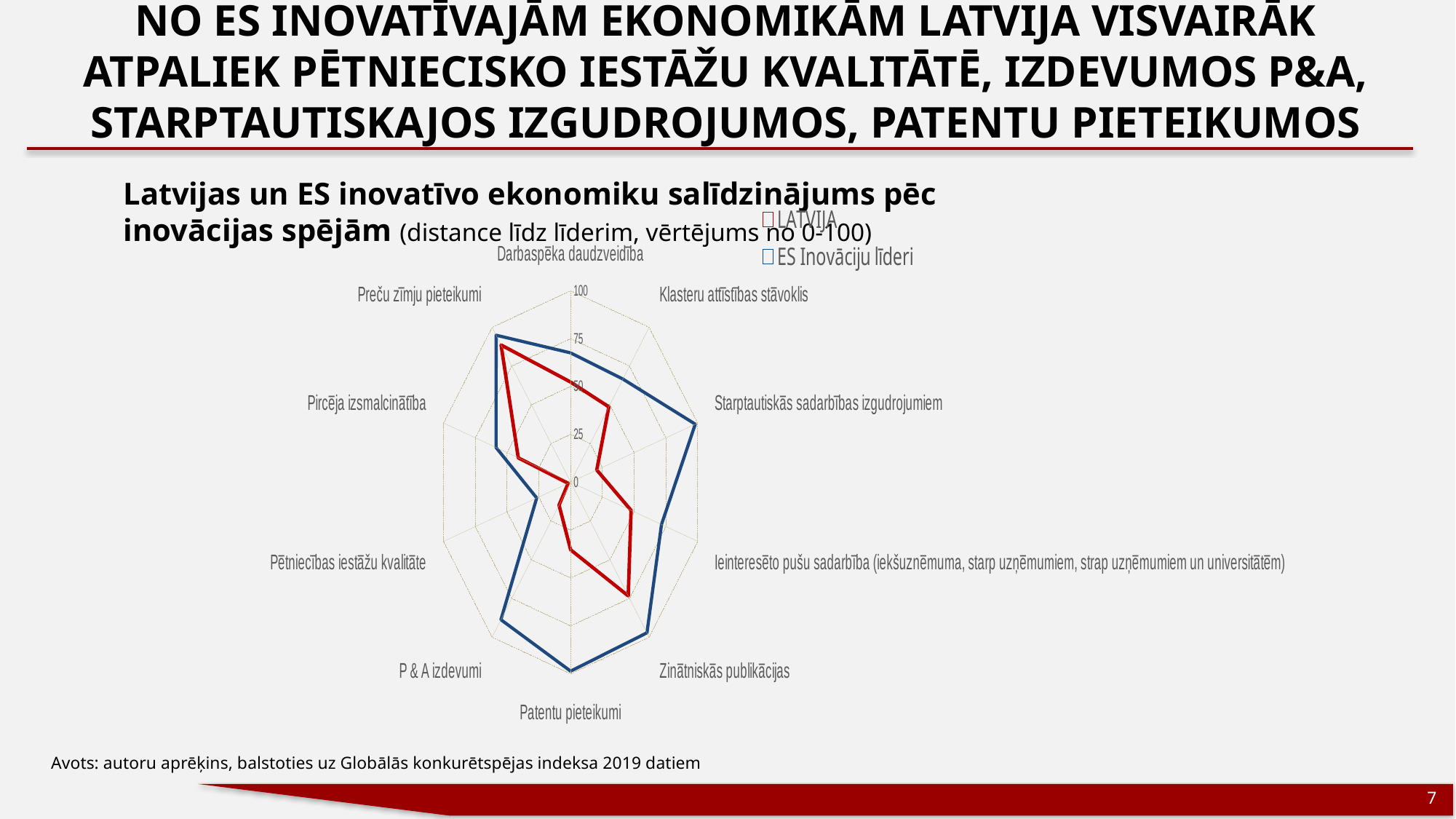
How many categories (axes) does the radar chart have? 10 What are the two series named in the legend? LATVIJA and ES Inovāciju līderi Which series is drawn in red on the chart? LATVIJA Is the value for LATVIJA on Pētniecības iestāžu kvalitāte greater or less than 25? less Is the value for LATVIJA on Patentu pieteikumi greater or less than 50? less Which series has the larger value on Patentu pieteikumi, LATVIJA or ES Inovāciju līderi? ES Inovāciju līderi How many series does the chart legend list? 2 What kind of chart is shown on the slide? Radar chart On which category does the LATVIJA series reach its highest value? Preču zīmju pieteikumi Is the value for LATVIJA on Starptautiskās sadarbības izgudrojumiem greater or less than 25? less